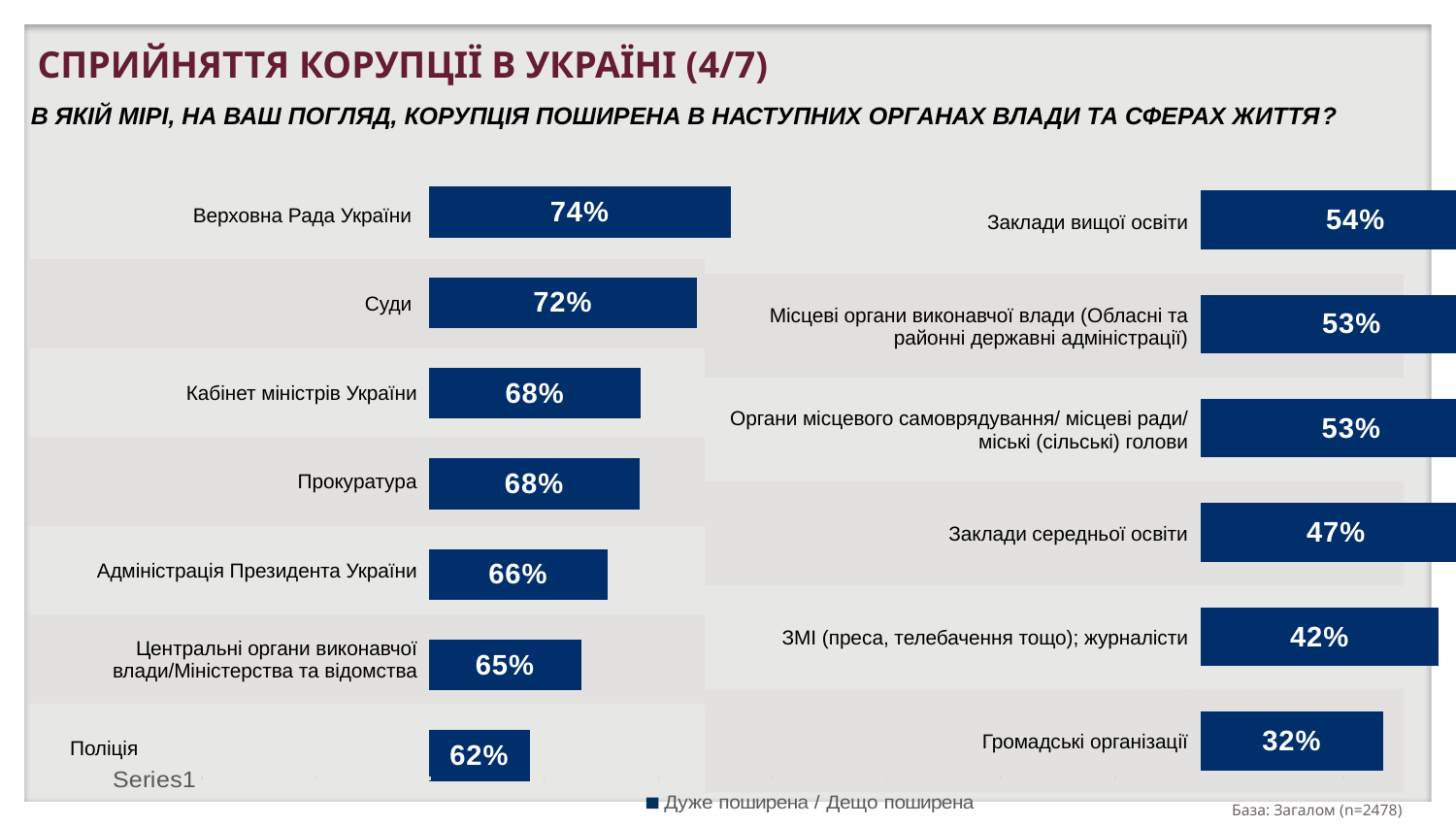
In the left chart, what is the value for Верховна Рада України? 74% In the right chart, which category has the highest value? Заклади вищої освіти In the right chart, what is the value for ЗМІ (преса, телебачення тощо); журналісти? 42% In the left chart, which is larger: the value for Суди or the value for Адміністрація Президента України? Суди In the right chart, what is the difference between the values for Заклади середньої освіти and Громадські організації? 15% In the left chart, which category has the highest value? Верховна Рада України What type of chart is used on the slide? Bar chart In the right chart, which category has the lowest value? Громадські організації In the left chart, what is the value for Поліція? 62% In the left chart, what is the difference between the values for Верховна Рада України and Поліція? 12% How many categories are shown in the left chart? 7 In the right chart, what is the value for Громадські організації? 32%